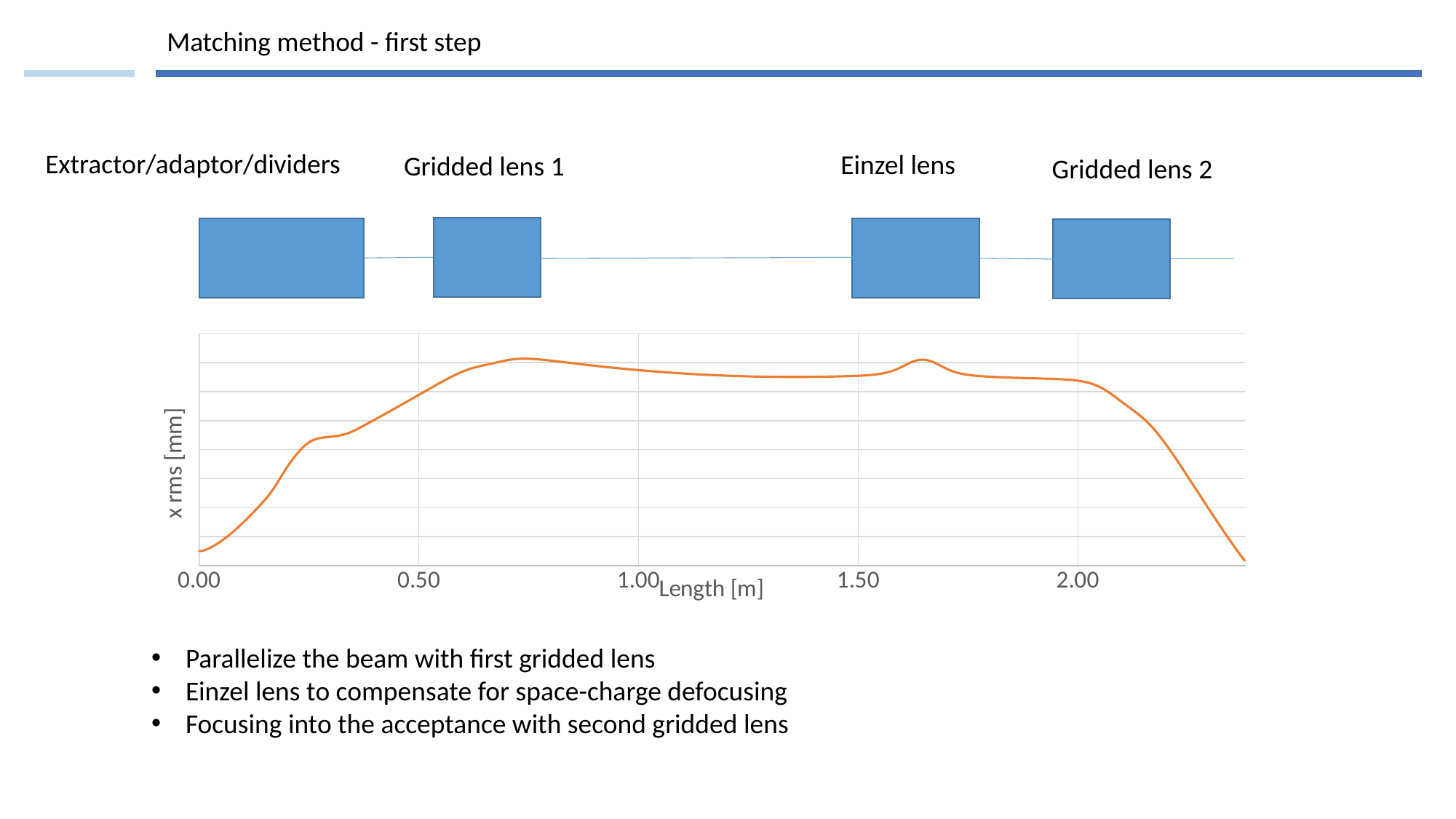
How many labelled tick marks are shown on the x axis? 5 What is the label of the x axis of the chart? Length [m] Does the curve rise or fall between 0.00 and 0.50 on the x axis? rise Does the curve rise or fall between 2.00 and the right end of the x axis? fall Is the value of the curve at 0.50 m greater or less than its value at 0.00 m? greater What is the label of the y axis of the chart? x rms [mm] What is the largest tick label shown on the x axis? 2.00 Is the value of the curve at 1.00 m greater or less than its value at 2.00 m? greater What kind of chart is shown on the slide? line chart How many data series are plotted in the chart? 1